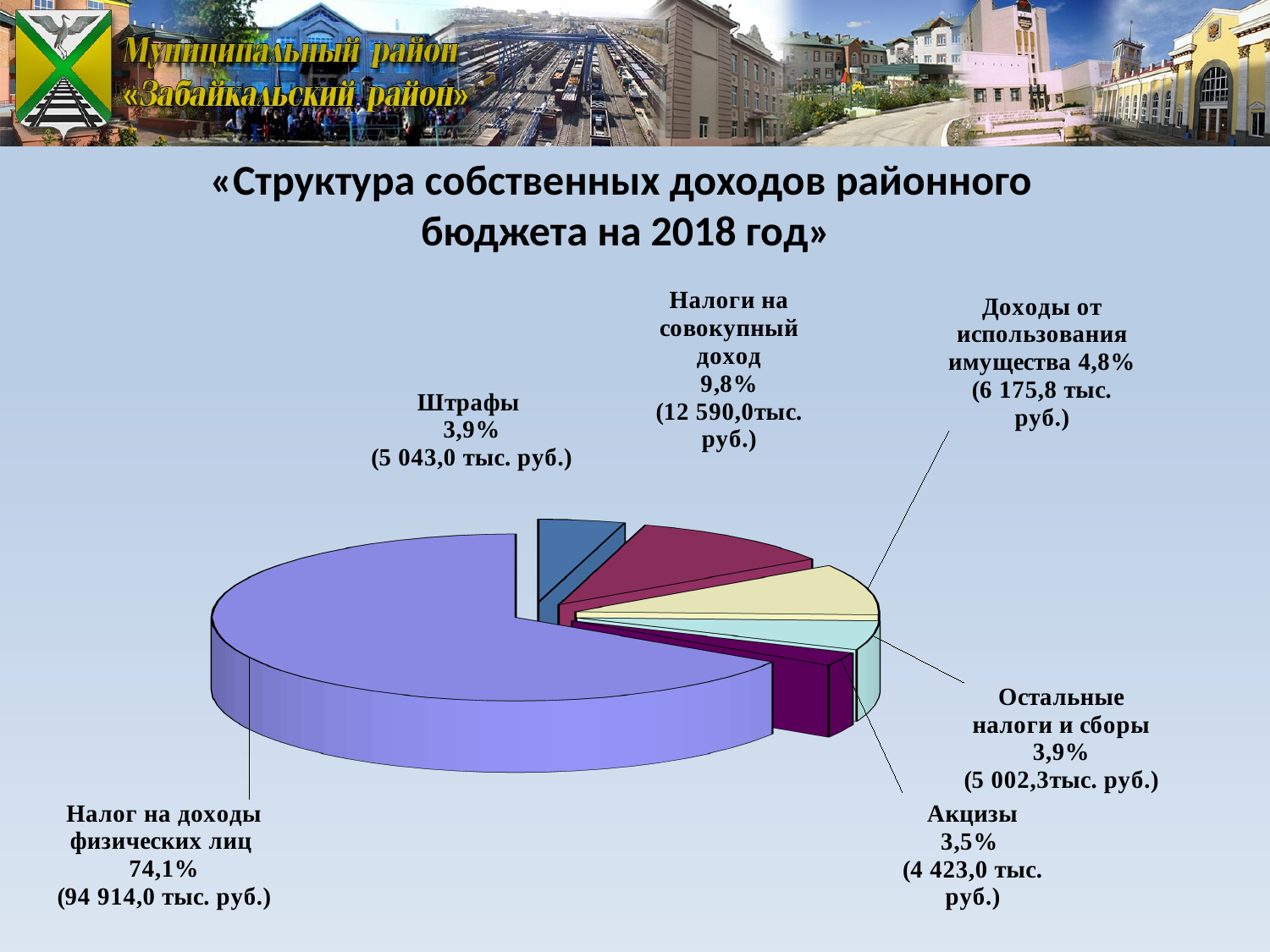
How many slices does the pie chart have? 6 Which is larger: the share for «Налоги на совокупный доход» or for «Доходы от использования имущества»? Налоги на совокупный доход Which category has the largest share of the pie? Налог на доходы физических лиц What amount in тыс. руб. is shown for «Штрафы»? 5 043,0 тыс. руб. What type of chart is shown on the slide? Pie chart What amount in тыс. руб. is shown for «Акцизы»? 4 423,0 тыс. руб. What is the difference in percentage points between «Налоги на совокупный доход» (9,8%) and «Доходы от использования имущества» (4,8%)? 5,0% What percentage is shown for «Доходы от использования имущества»? 4,8% What amount in тыс. руб. is shown for «Налоги на совокупный доход»? 12 590,0 тыс. руб. What is the title of the chart on the slide? «Структура собственных доходов районного бюджета на 2018 год» What share of the pie does «Налог на доходы физических лиц» represent? 74,1% Which category has the smallest share of the pie? Акцизы